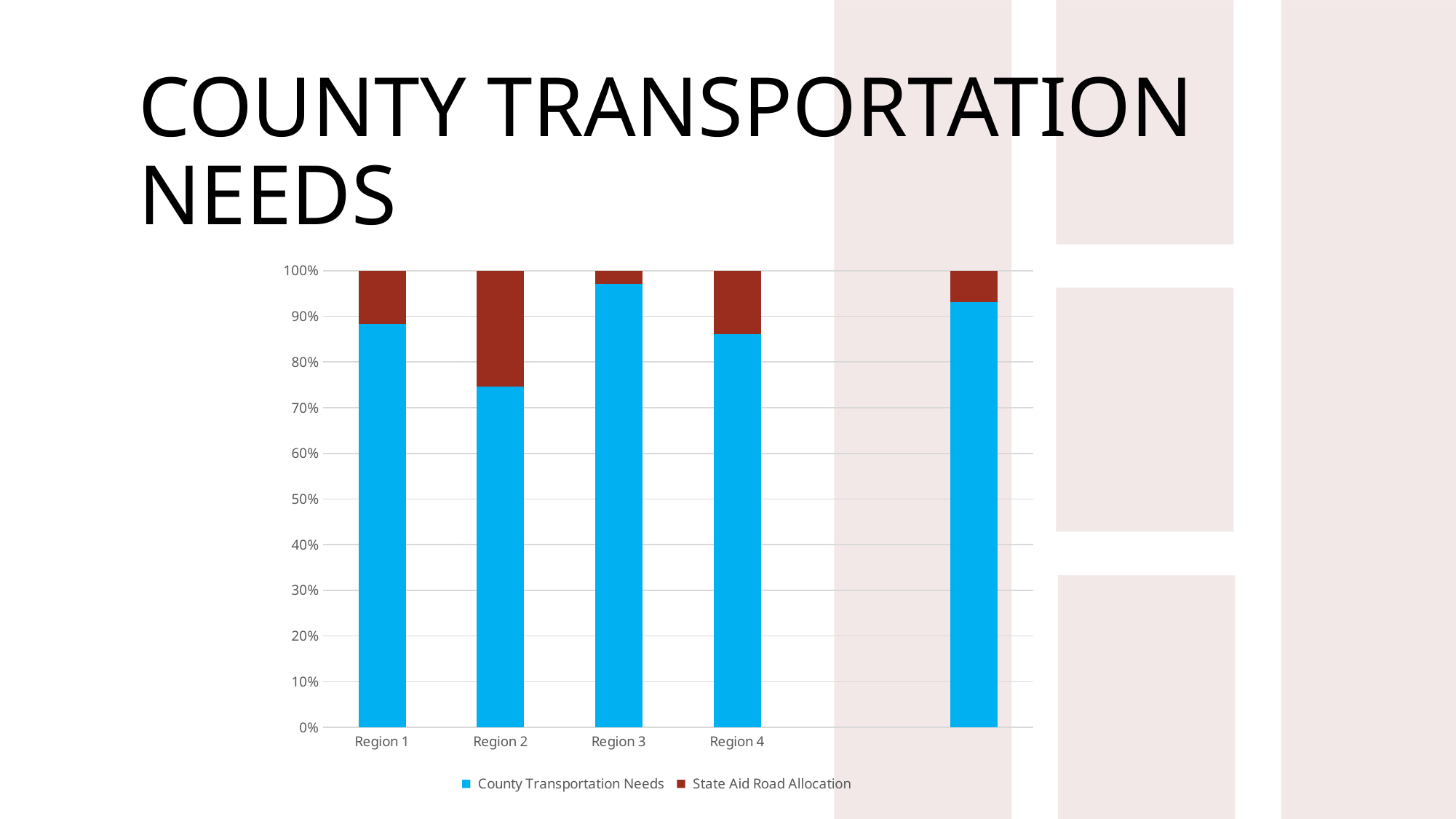
Is the County Transportation Needs value for Region 4 greater or less than 90%? less What kind of chart is shown on the slide? Stacked bar chart What are the two series named in the legend? County Transportation Needs and State Aid Road Allocation Is the County Transportation Needs value for Region 1 greater or less than 80%? greater Is the County Transportation Needs value for Region 3 greater or less than 90%? greater Which colour represents State Aid Road Allocation in the chart? Dark red Among Regions 1 to 4, which region has the highest County Transportation Needs share? Region 3 Which is larger, the County Transportation Needs share for Region 1 or for Region 2? Region 1 What is the total of the stacked bar for Region 1? 100% Among Regions 1 to 4, which region has the largest State Aid Road Allocation share? Region 2 How many series does the legend list? 2